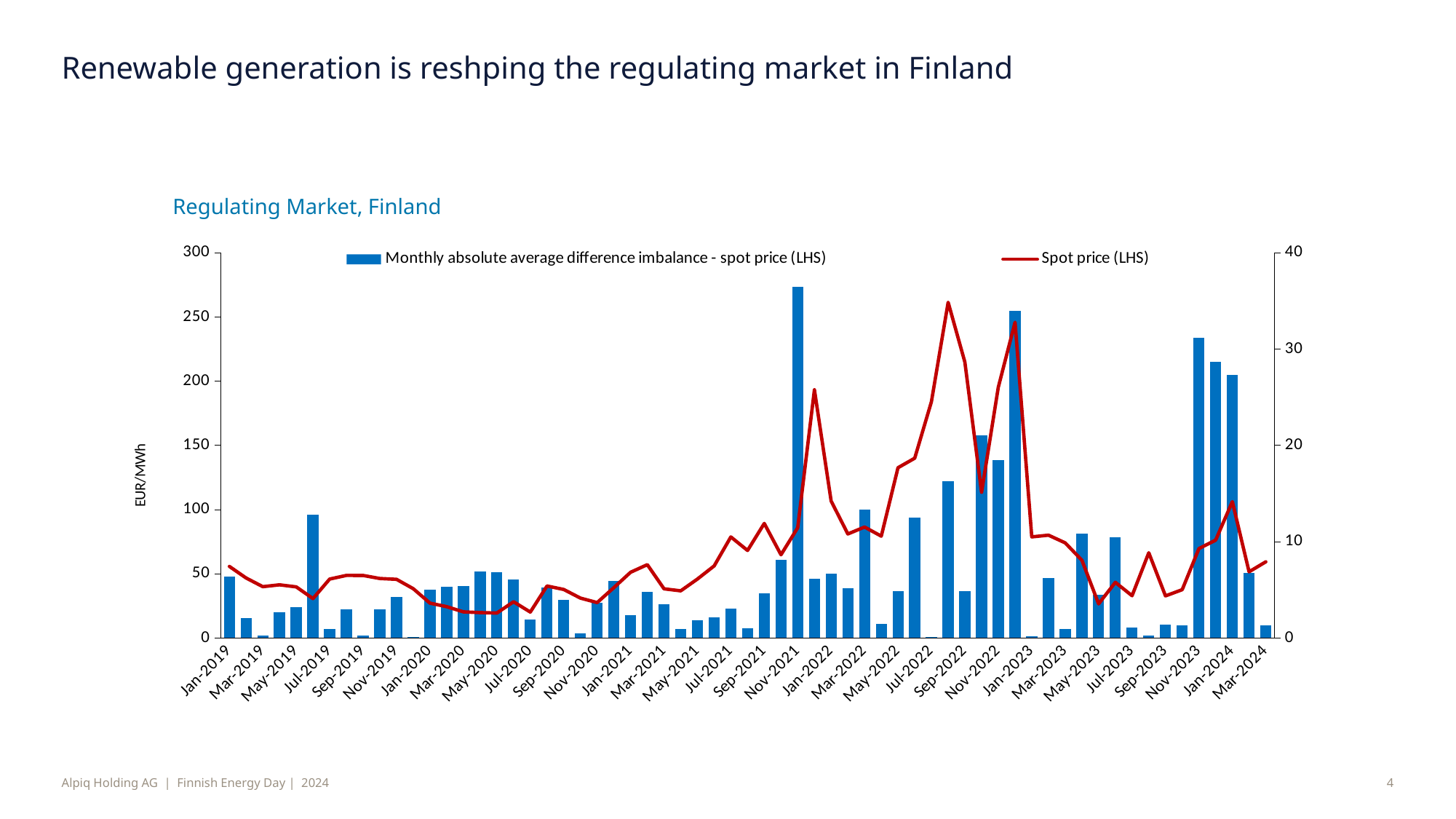
Which bar is taller, Nov-2021 or Jul-2019? Nov-2021 Is the bar value for Nov-2021 greater or less than 250? greater What is the maximum value shown on the left vertical axis? 300 What is the title of the chart? Regulating Market, Finland Is the bar value for Jul-2019 greater or less than 100? less What kind of chart is shown on the slide? A combined bar and line chart Is the spot price at its peak around Sep-2022 greater or less than 30 on the right-hand axis? greater In which month is the bar for monthly absolute average difference imbalance - spot price the highest? Nov-2021 Which series is drawn as a red line? Spot price (LHS) How many series does the chart legend list? 2